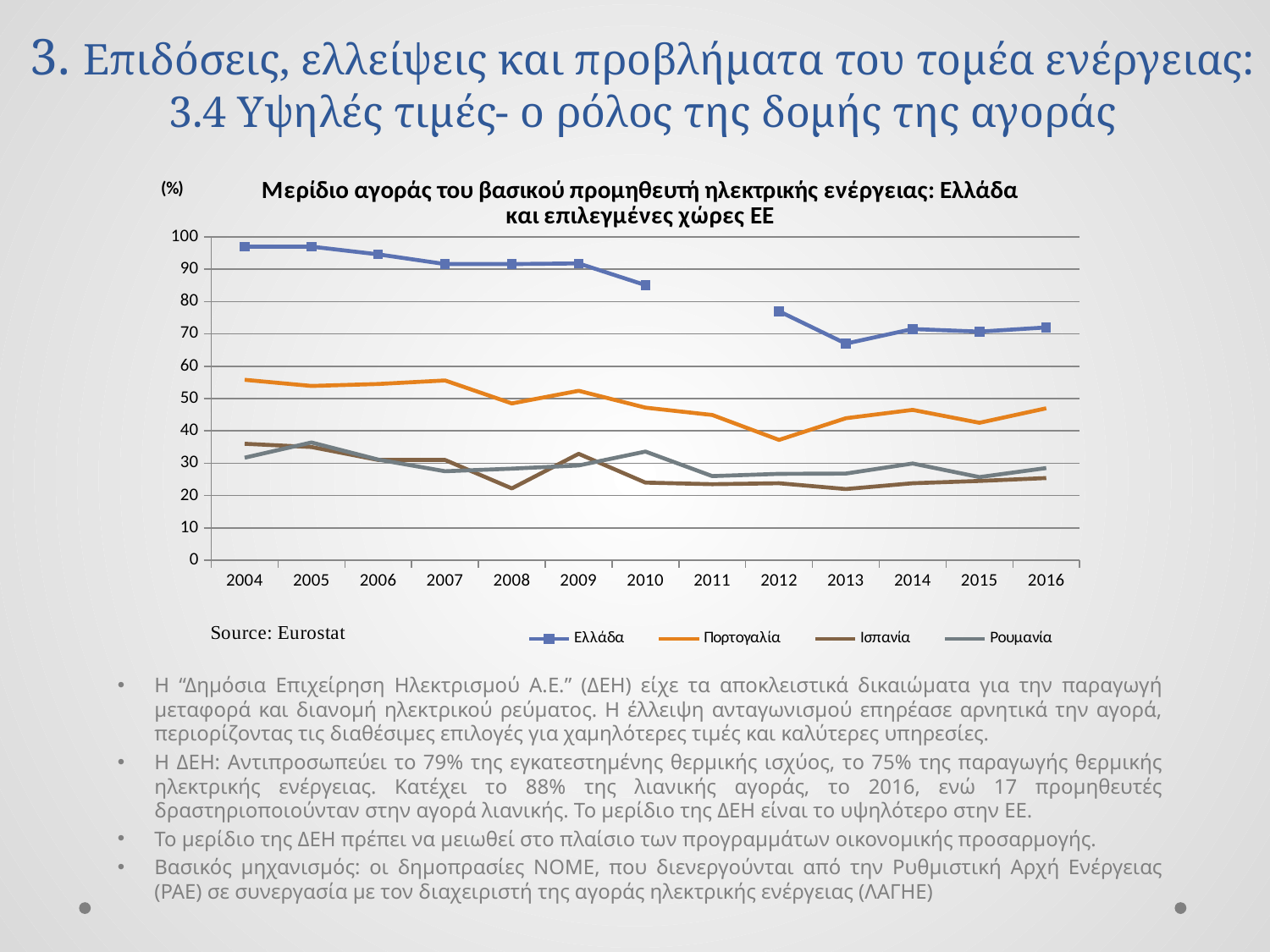
Does the value for Ελλάδα rise or fall from 2004 to 2016? fall Is the value for Πορτογαλία in 2012 greater or less than 40? less Which is larger in 2004, the value for Πορτογαλία or the value for Ισπανία? Πορτογαλία In which year is the value for Πορτογαλία lowest? 2012 Which series has the lowest value in 2013? Ισπανία Is the value for Ισπανία in 2008 greater or less than 30? less How many years are shown on the x axis? 13 Is the value for Ελλάδα in 2004 greater or less than 90? greater How many series does the legend list? 4 Which series has the highest value in 2004? Ελλάδα What kind of chart is shown on the slide? line chart